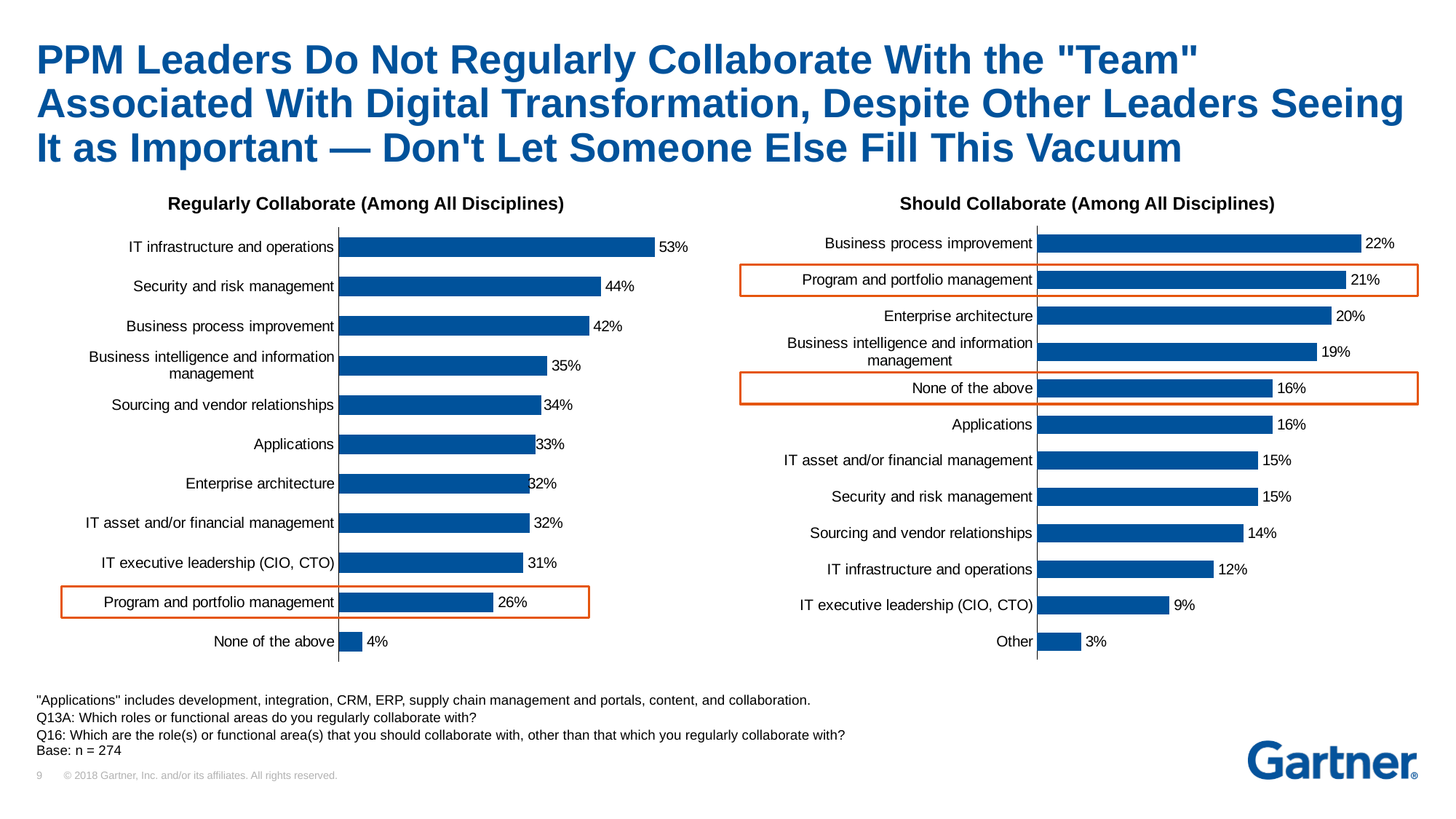
What kind of chart is the "Should Collaborate (Among All Disciplines)" chart? Bar chart In the "Regularly Collaborate (Among All Disciplines)" chart, what is the difference between IT infrastructure and operations and None of the above? 49% In the "Regularly Collaborate (Among All Disciplines)" chart, which category has the lowest value? None of the above In the "Regularly Collaborate (Among All Disciplines)" chart, what is the value for IT infrastructure and operations? 53% In the "Should Collaborate (Among All Disciplines)" chart, what is the value for Program and portfolio management? 21% In the "Should Collaborate (Among All Disciplines)" chart, which is larger: Enterprise architecture or IT infrastructure and operations? Enterprise architecture In the "Should Collaborate (Among All Disciplines)" chart, which category has the highest value? Business process improvement How many categories are shown in the "Regularly Collaborate (Among All Disciplines)" chart? 11 In the "Should Collaborate (Among All Disciplines)" chart, what is the value for Other? 3% How many categories are shown in the "Should Collaborate (Among All Disciplines)" chart? 12 In the "Should Collaborate (Among All Disciplines)" chart, which two categories are highlighted with orange boxes? Program and portfolio management and None of the above In the "Regularly Collaborate (Among All Disciplines)" chart, what is the difference between Security and risk management and Program and portfolio management? 18%